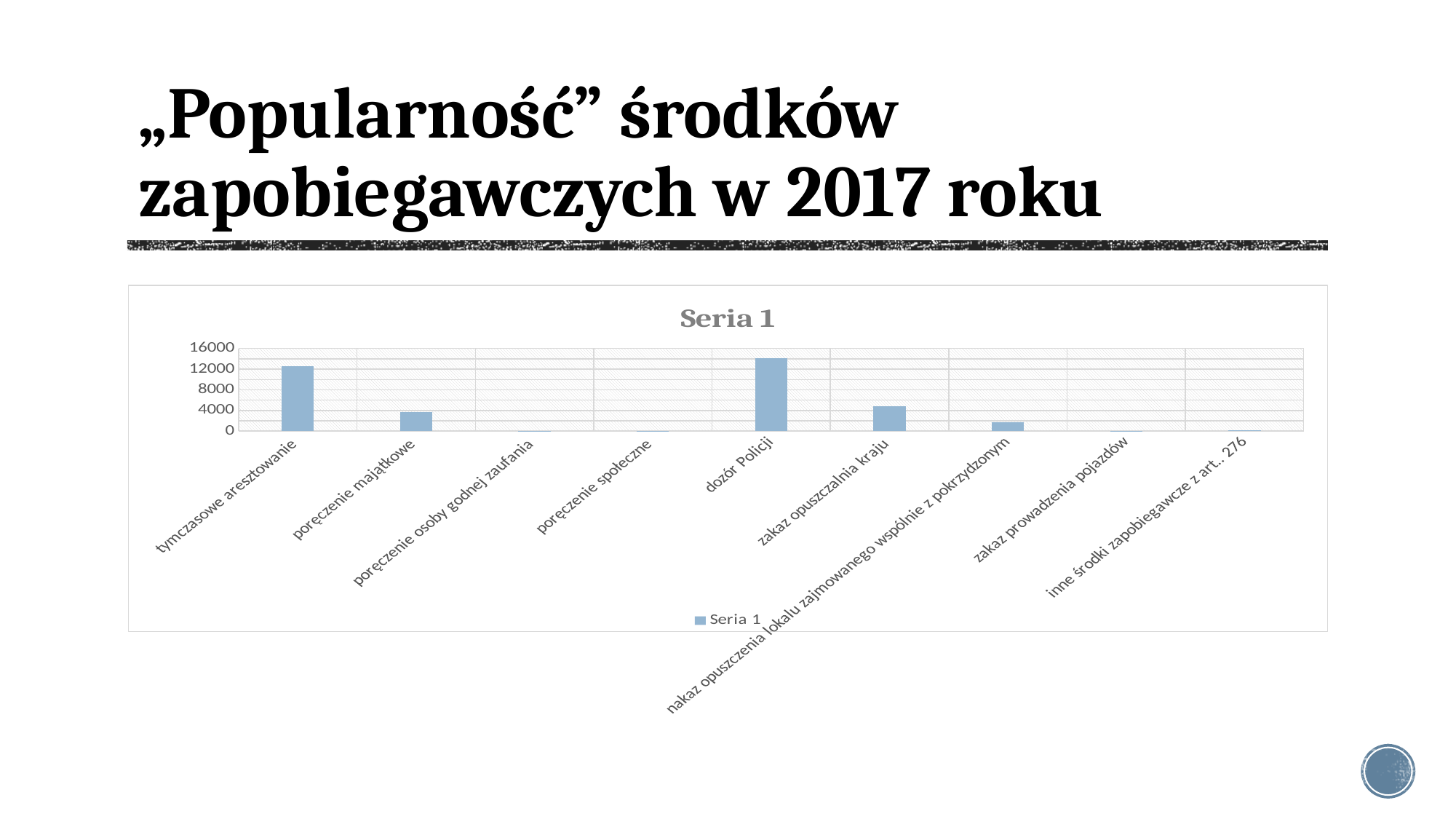
What is the highest value shown on the chart's vertical axis? 16000 How many series does the chart's legend list? 1 Is the value for nakaz opuszczenia lokalu zajmowanego wspólnie z pokrzydzonym greater or less than 4000? less Which category has the highest value in the chart? dozór Policji Which is larger, the value for zakaz opuszczalnia kraju or the value for nakaz opuszczenia lokalu zajmowanego wspólnie z pokrzydzonym? zakaz opuszczalnia kraju What is the title of the chart? Seria 1 Is the value for tymczasowe aresztowanie greater or less than 8000? greater Is the value for poręczenie majątkowe greater or less than 4000? less Which is larger, the value for tymczasowe aresztowanie or the value for poręczenie majątkowe? tymczasowe aresztowanie How many categories are plotted on the x axis of the chart? 9 What kind of chart is shown on the slide? bar chart